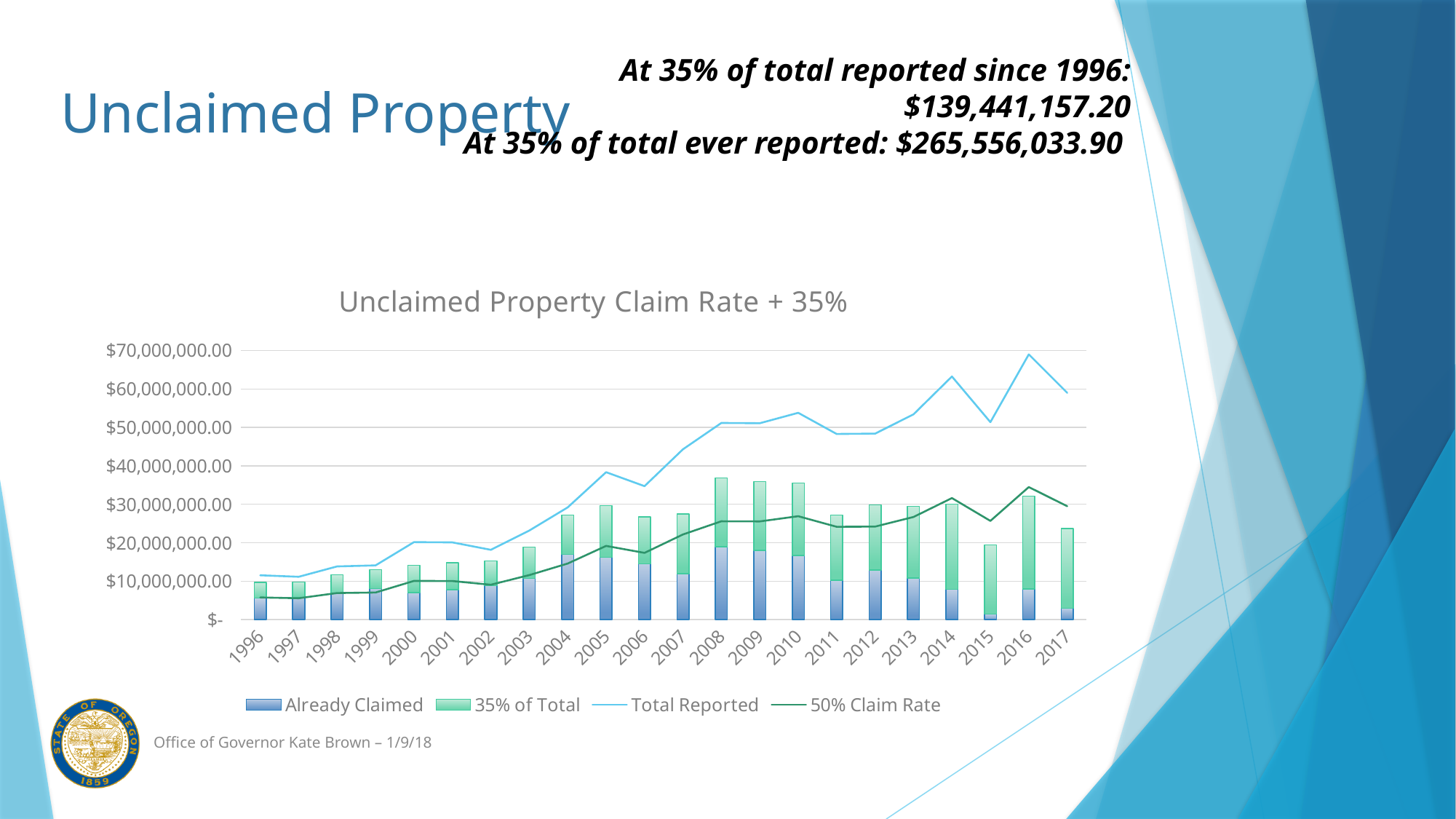
Is the Total Reported value for 2016 greater or less than $60,000,000.00? greater How many years are shown on the x axis of the chart? 22 Which year has the larger Total Reported value, 2016 or 2017? 2016 Does the Total Reported line generally rise or fall from 1996 to 2017? rise What kind of chart is shown on the slide? Combination bar and line chart How many series does the chart legend list? 4 What is the title of the chart? Unclaimed Property Claim Rate + 35% Is the Already Claimed value for 2015 greater or less than $10,000,000.00? less Is the total height of the stacked bar for 2008 greater or less than $30,000,000.00? greater Which series are shown as lines in the chart? Total Reported and 50% Claim Rate In which year does the Total Reported line reach its highest value? 2016